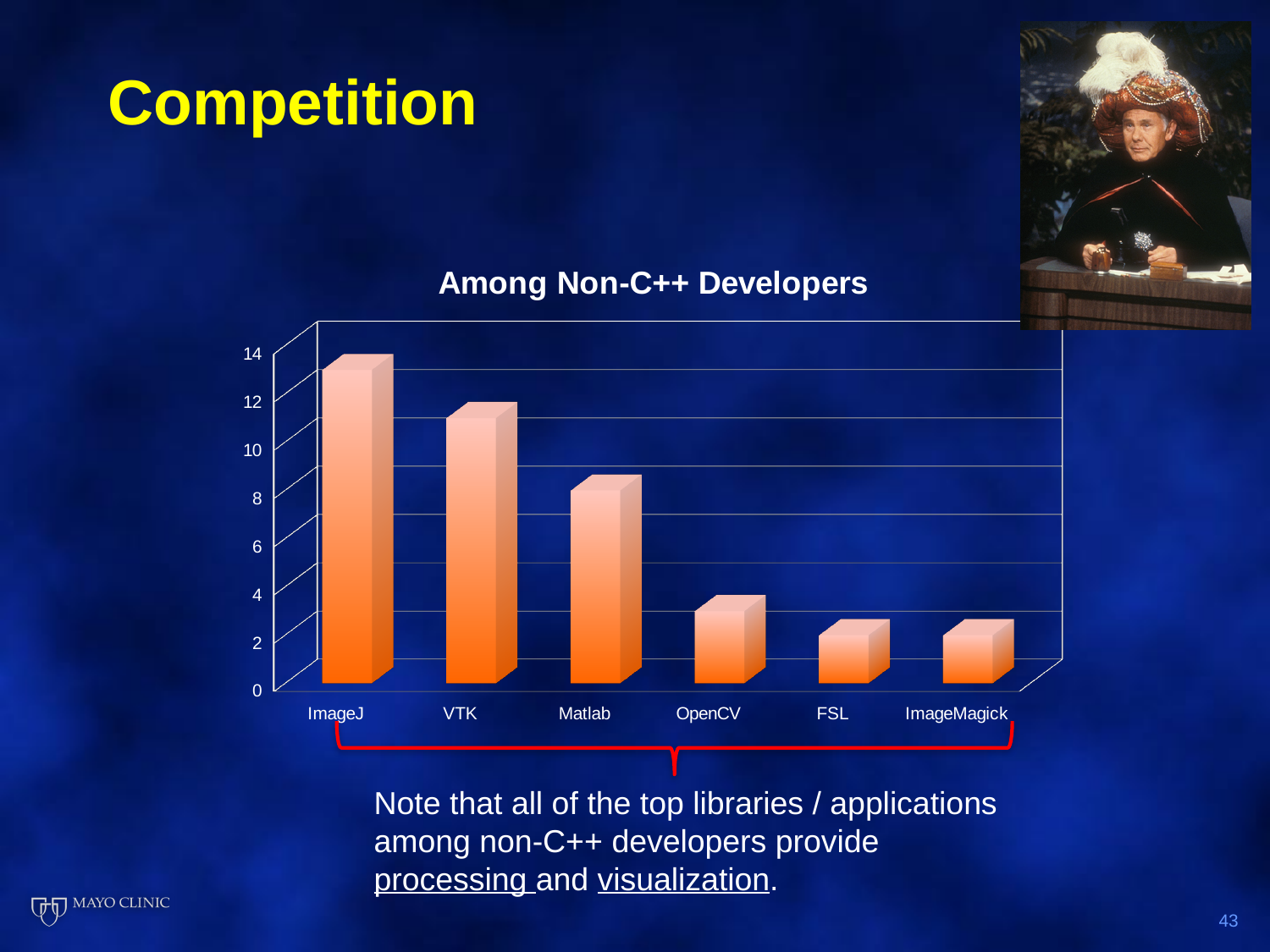
Is the value for OpenCV greater or less than 6? less Is the value for FSL greater or less than 4? less Is the value for Matlab greater or less than 10? less Which category has the highest bar in the chart? ImageJ What is the title of the chart? Among Non-C++ Developers What kind of chart is shown on the slide? bar chart Which has the larger value, VTK or Matlab? VTK Do the bar values rise or fall from left to right along the x axis? fall How many categories are shown on the x axis of the chart? 6